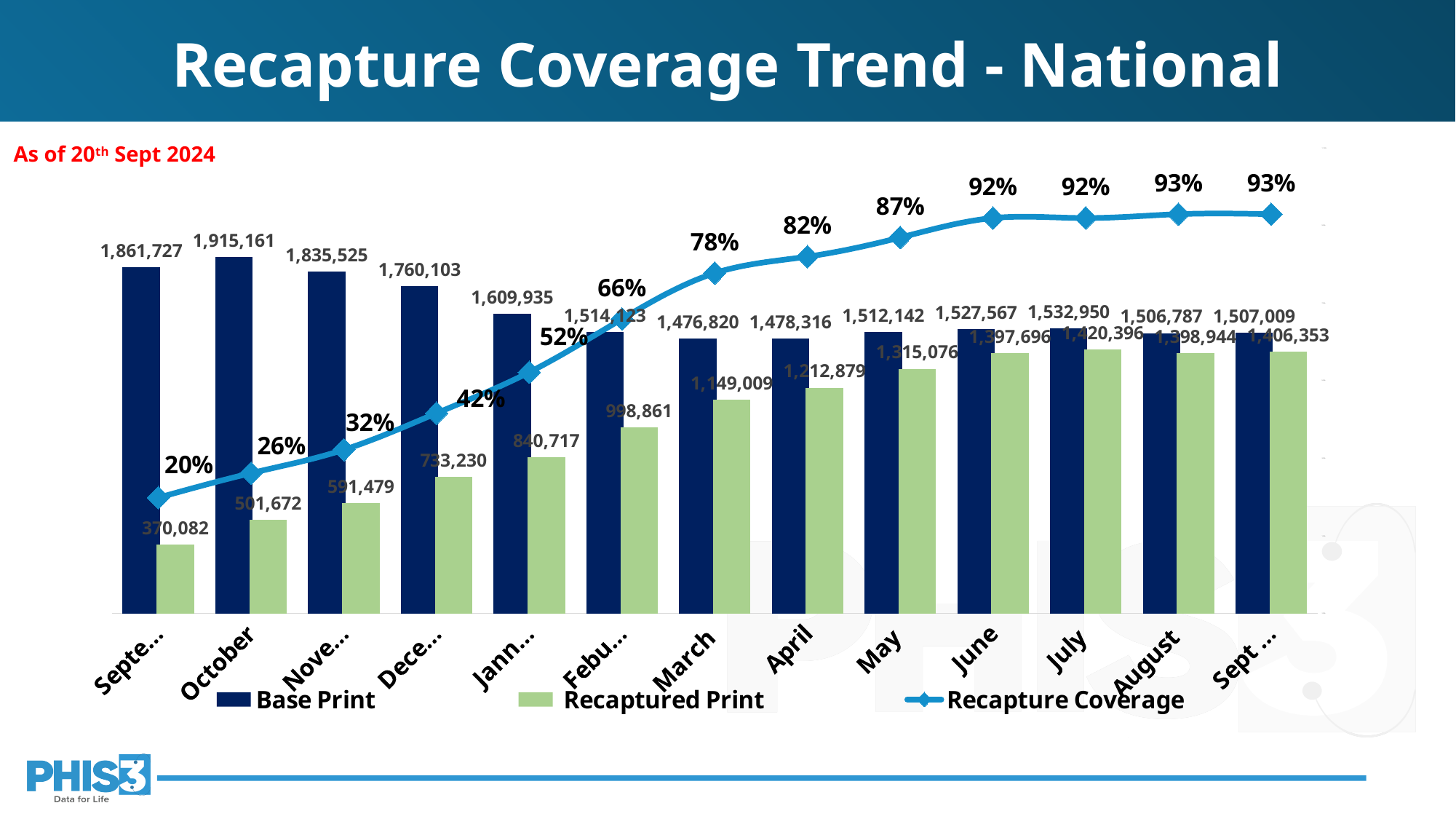
Does the Recapture Coverage line rise or fall across the months? Rises What is the Recapture Coverage for March? 78% Which is larger, the Base Print value for October or for May? October What is the difference between Base Print and Recaptured Print in March? 327,811 What is the Recaptured Print value for April? 1,212,879 By how many percentage points did Recapture Coverage increase from April to August? 11 percentage points Which month has the highest Base Print value? October What is the Base Print value for October? 1,915,161 What is the Recapture Coverage for June? 92% What is the title of the chart? Recapture Coverage Trend - National How many series does the legend list? 3 What is the Recaptured Print value for March? 1,149,009